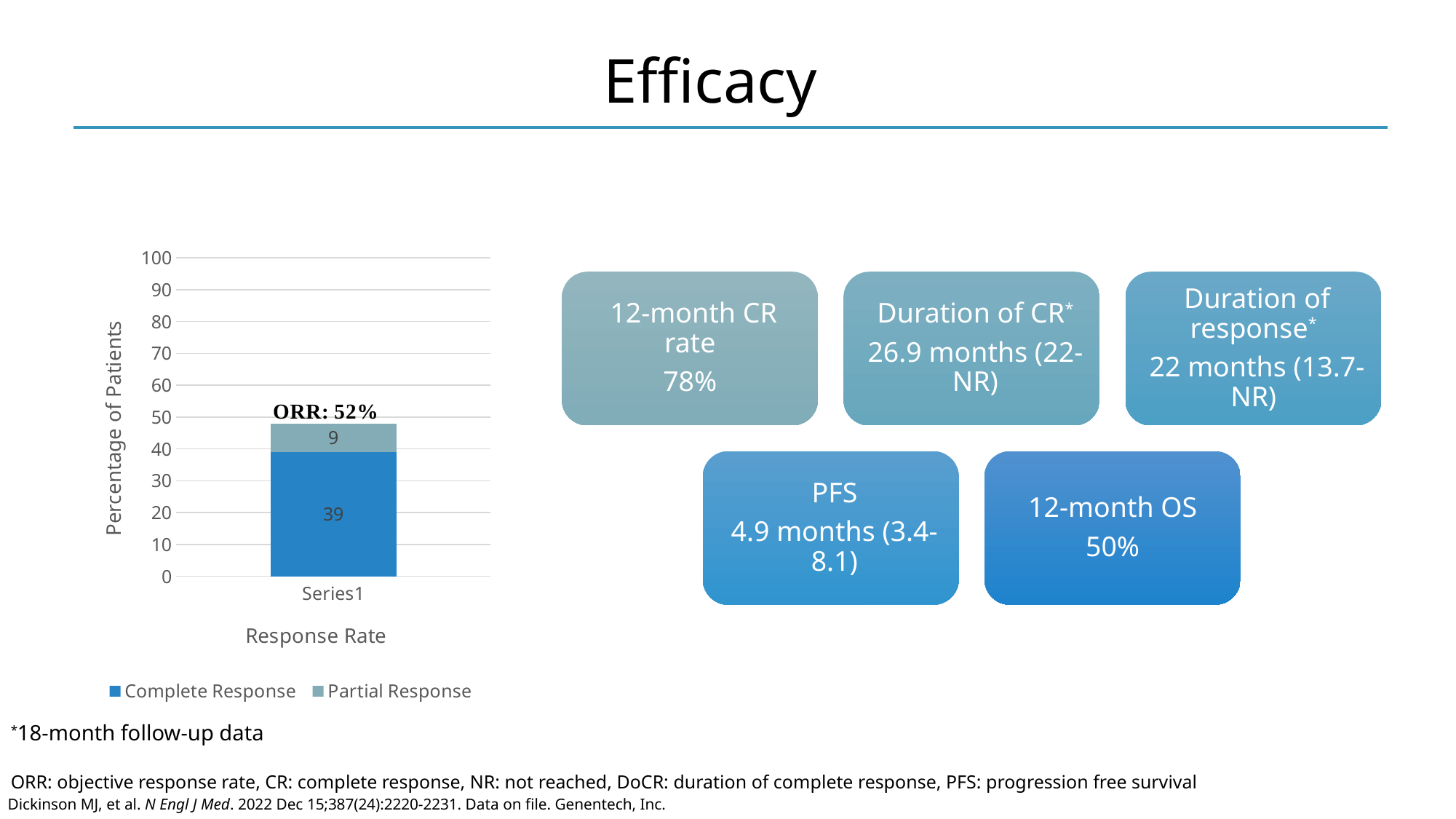
How many series does the chart legend list? 2 What ORR value is annotated above the stacked bar? 52% Which segment is larger in the stacked bar, Complete Response or Partial Response? Complete Response What is the value of the Complete Response segment in the stacked bar? 39 What is the total of the stacked bar for Series1 (Complete Response plus Partial Response)? 48 How many categories are plotted on the x axis of the chart? 1 Is the Complete Response value greater or less than 30? greater Is the top of the stacked bar greater or less than 50? less What kind of chart is shown on the slide? Stacked bar chart What is the value of the Partial Response segment in the stacked bar? 9 What is the label on the vertical axis of the chart? Percentage of Patients What is the difference between the Complete Response value and the Partial Response value? 30